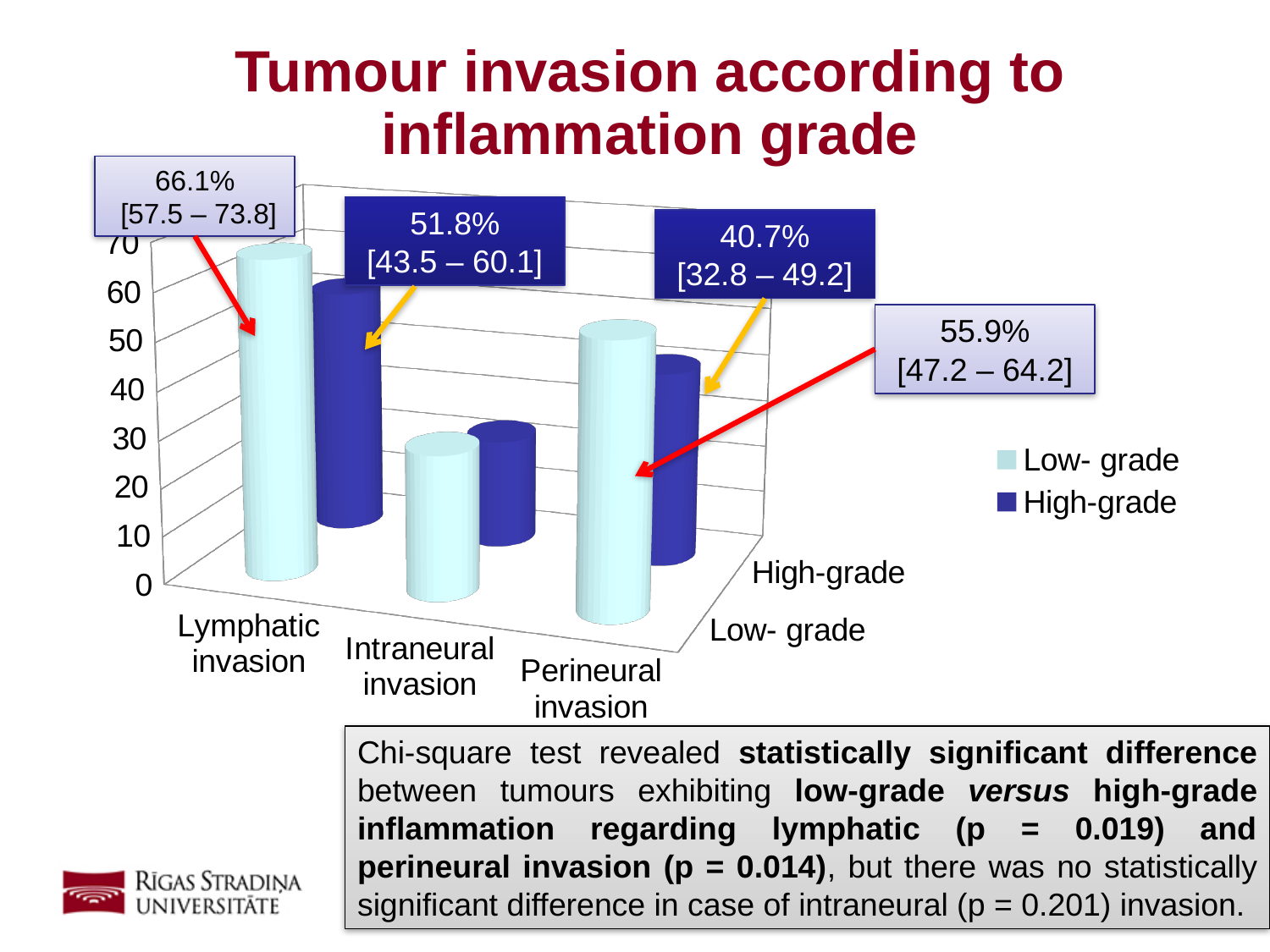
How many invasion categories are shown on the x axis? 3 What is the confidence interval shown for Low-grade lymphatic invasion? [57.5 – 73.8] For perineural invasion, which is larger: the Low-grade or the High-grade value? Low-grade What is the difference between the Low-grade and High-grade values for perineural invasion? 15.2 percentage points How many series does the legend list? 2 What is the difference between the Low-grade and High-grade values for lymphatic invasion? 14.3 percentage points Which invasion type has the lowest Low-grade value? Intraneural invasion What is the value for High-grade perineural invasion? 40.7% What is the value for High-grade lymphatic invasion? 51.8% What is the value for Low-grade lymphatic invasion? 66.1% Is the Low-grade value for intraneural invasion greater or less than 40? less What is the value for Low-grade perineural invasion? 55.9%